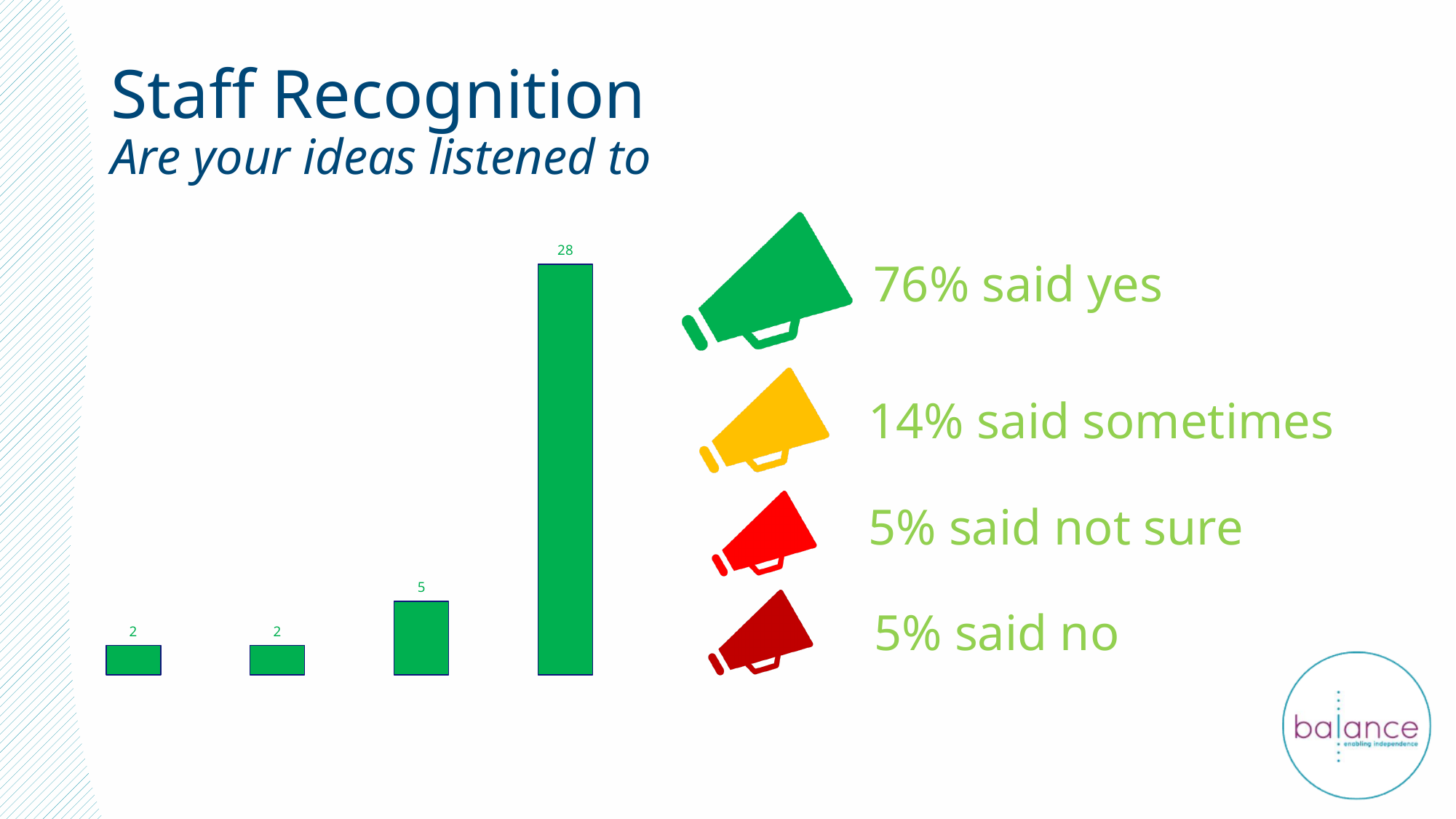
What is the value of the third bar from the left? 5 What is the value of the fourth bar from the left? 28 What is the value of the first bar on the left? 2 Which is larger, the third bar or the fourth bar? the fourth bar What is the value shown on the shortest bars in the chart? 2 What colour are the bars in the chart? green What is the sum of all four bar values in the chart? 37 What kind of chart is shown on the slide? bar chart How many bars does the chart contain? 4 What is the value shown on the tallest bar in the chart? 28 What is the difference between the tallest bar (28) and the third bar (5)? 23 Do the bar values rise or fall from left to right across the chart? rise